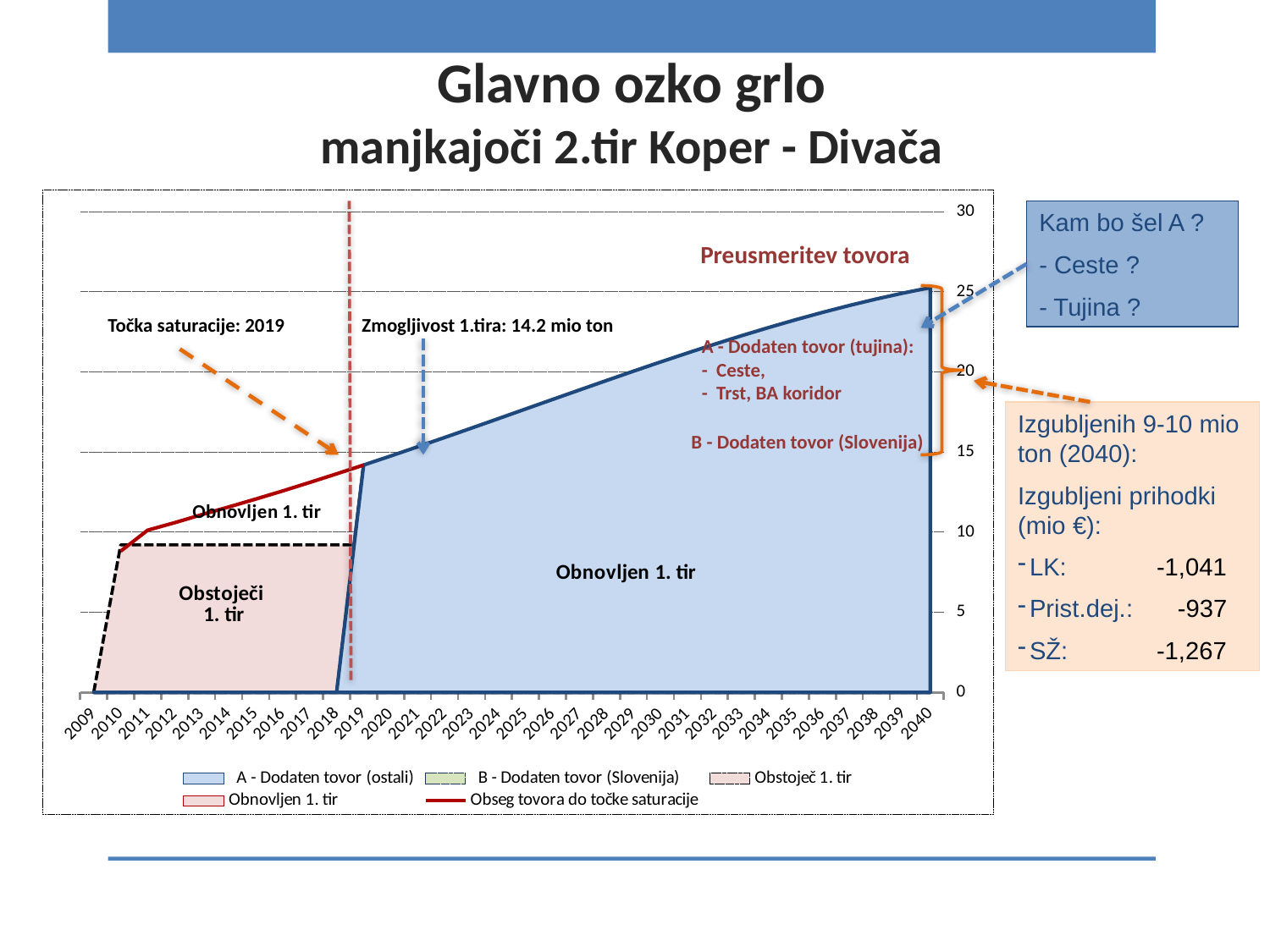
Is the total freight volume in 2040 greater or less than 20? greater What is the first year shown on the x axis of the chart? 2009 According to the annotation on the chart, in which year is the saturation point (Točka saturacije)? 2019 Is the value of the Obstoječi 1. tir area in 2015 greater or less than 10? less How many series does the chart legend list? 5 What kind of chart is shown on the slide? combination area and line chart Does the total freight volume in the chart rise or fall from 2019 to 2040? rise How many years are shown on the x axis of the chart? 32 Is the total freight volume in 2035 greater or less than 20? greater What is the last year shown on the x axis of the chart? 2040 According to the annotation on the chart, what is the capacity of the first track (Zmogljivost 1. tira)? 14.2 mio ton